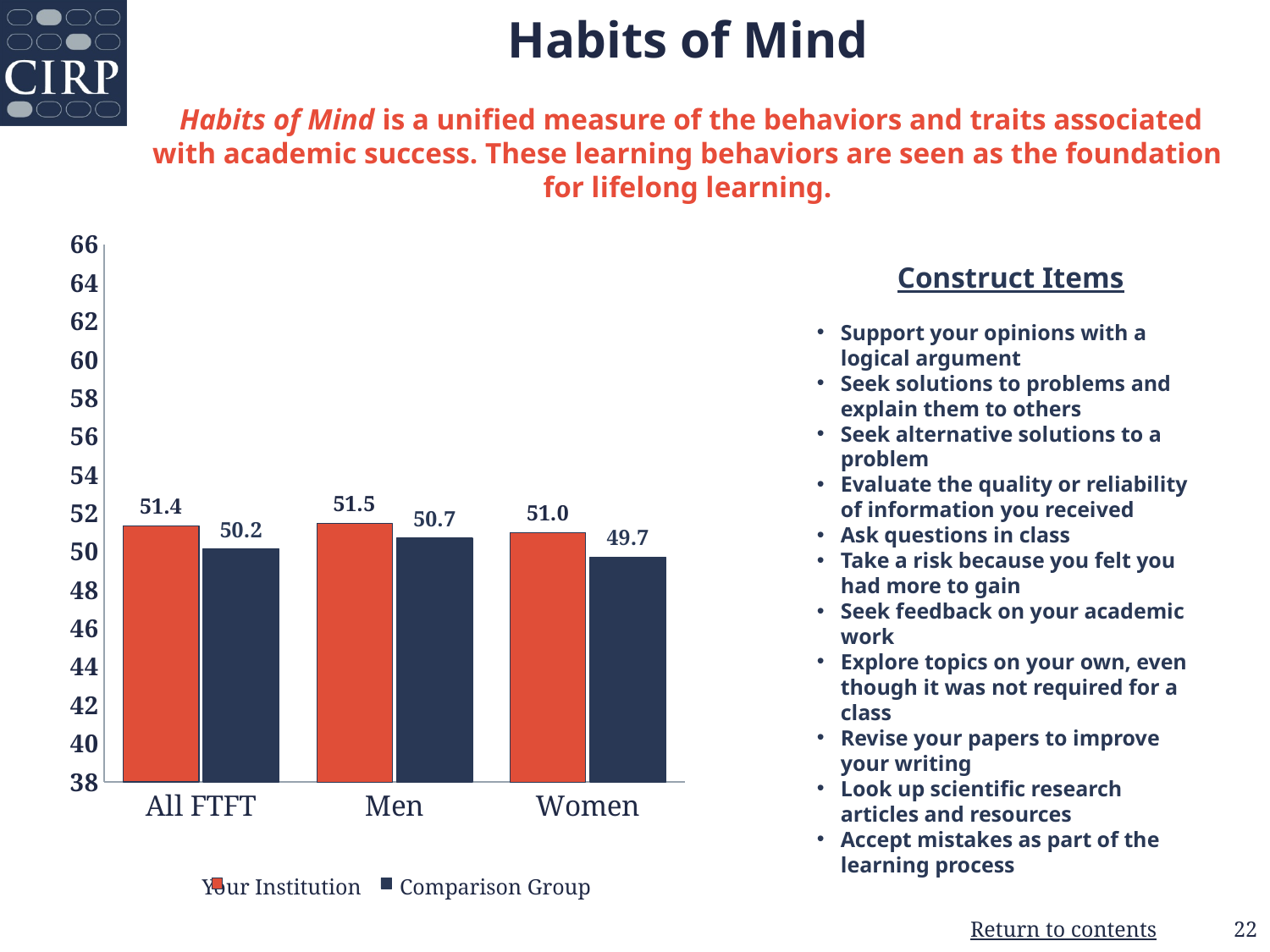
What is the Your Institution value for All FTFT? 51.4 Which series is shown in dark blue in the legend? Comparison Group How many categories are shown on the x axis? 3 Which category has the highest Your Institution value? Men What kind of chart is shown on the slide? Bar chart Which is larger for Men: Your Institution or Comparison Group? Your Institution How many series does the legend list? 2 What is the difference between the Your Institution and Comparison Group values for All FTFT? 1.2 What is the Comparison Group value for Women? 49.7 What is the difference between the Your Institution and Comparison Group values for Women? 1.3 What is the Comparison Group value for Men? 50.7 Which category has the lowest Comparison Group value? Women